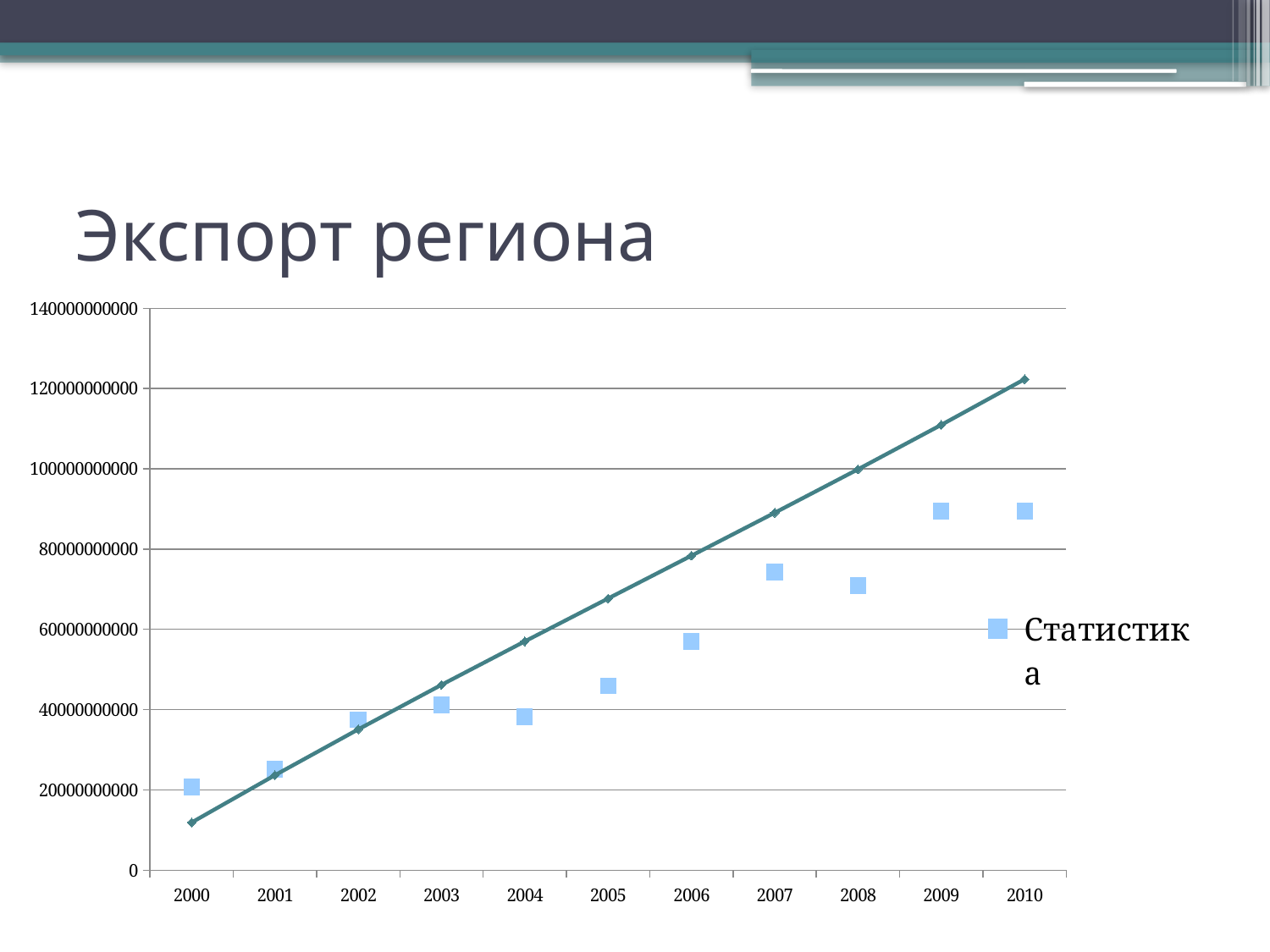
Which is larger, the value for Статистика in 2006 or in 2007? 2007 What is the title of the chart? Экспорт региона How many series does the legend list? 1 Is the value for Статистика in 2000 greater or less than 40000000000? less How many years are plotted along the x axis? 11 Do the values for Статистика generally rise or fall from 2000 to 2010? rise Is the value for Статистика in 2010 greater or less than 80000000000? greater What kind of chart is shown on the slide? line chart Which year has the lowest value for Статистика? 2000 Is the value for Статистика in 2007 greater or less than 60000000000? greater What is the name of the series listed in the legend? Статистика